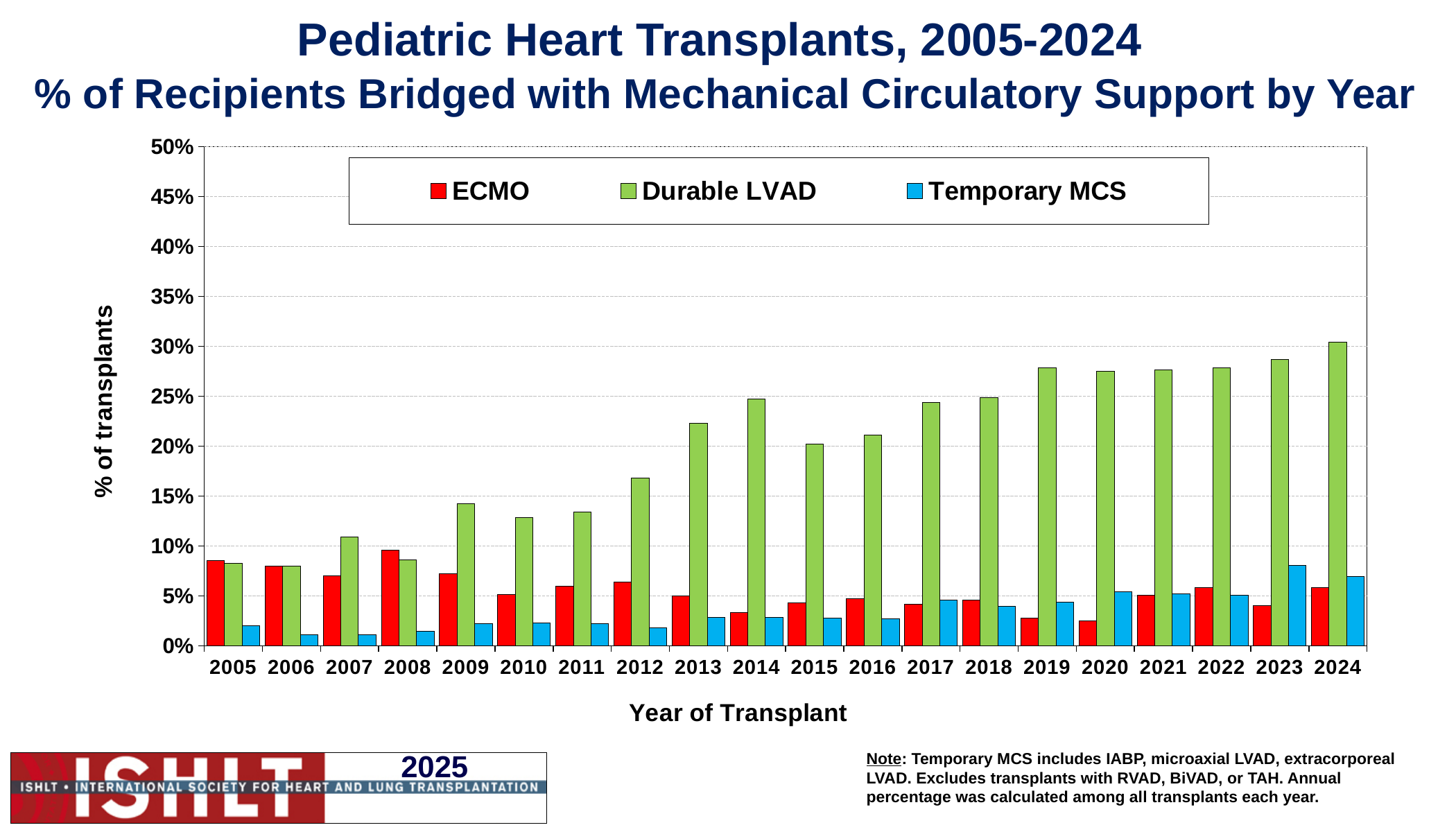
In 2023, which is larger: the ECMO value or the Temporary MCS value? Temporary MCS How many years are shown on the x axis? 20 Is the Durable LVAD value for 2024 greater or less than 25%? greater How many series does the legend list? 3 In which year is the Durable LVAD percentage highest? 2024 Is the ECMO value for 2008 greater or less than 10%? less Which colour represents ECMO in the legend? Red Does the Durable LVAD percentage generally rise or fall from 2005 to 2024? Rise Is the Temporary MCS value for 2023 greater or less than 5%? greater In which year is the Temporary MCS percentage highest? 2023 What kind of chart is shown on the slide? Bar chart In which year is the ECMO percentage highest? 2008